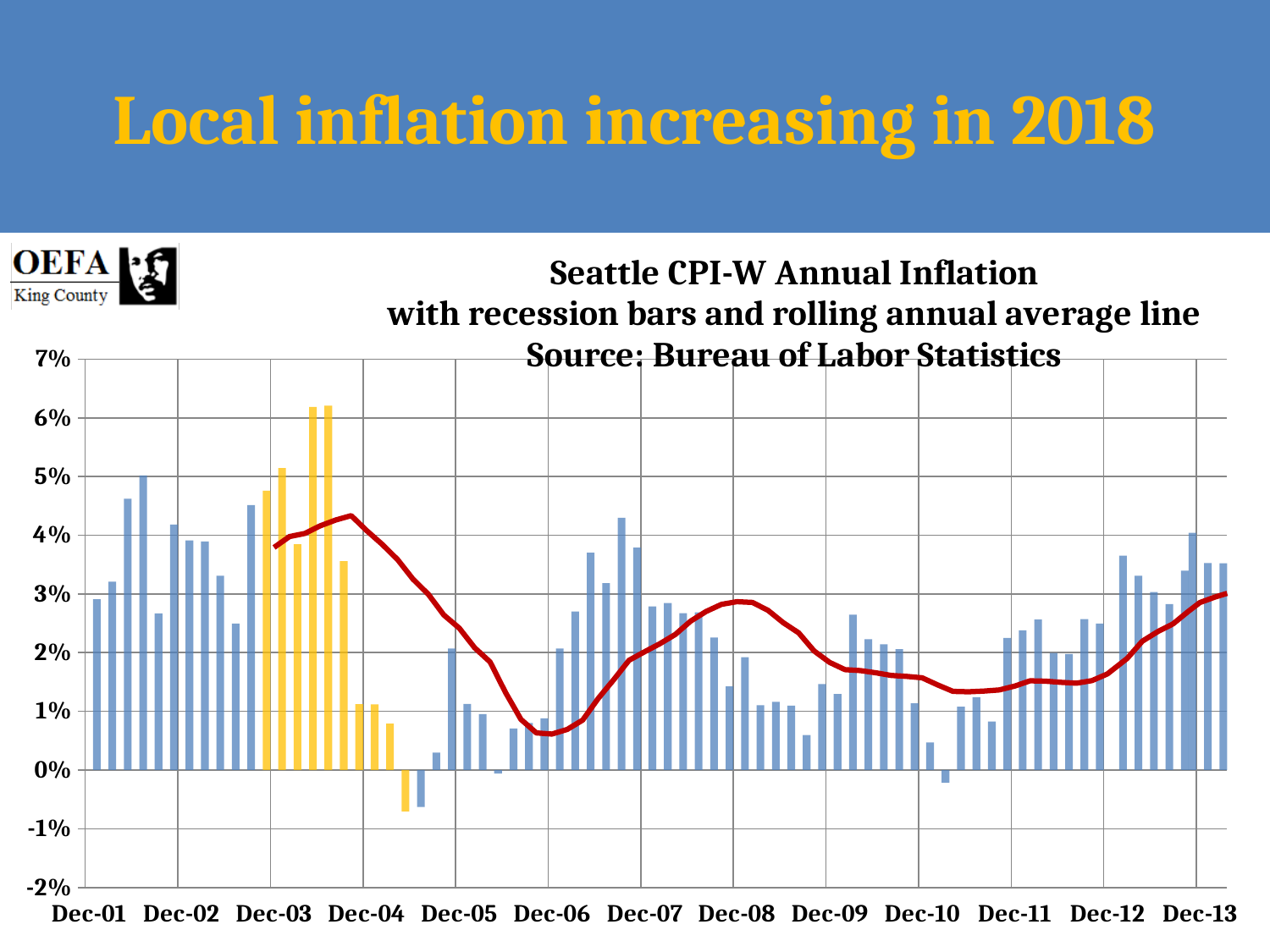
What source is cited in the chart title? Bureau of Labor Statistics Is the red rolling average line at Dec-06 greater or less than 1%? less Are the bars just after Dec-04 greater or less than 0%? less Is the value of the tallest yellow bar (between Dec-03 and Dec-04) greater or less than 6%? greater Does the red rolling average line rise or fall between Dec-04 and Dec-06? fall What kind of chart is shown on the slide? bar chart with a line overlay What colour are the recession bars on the chart? yellow Between which two x-axis labels do the tallest bars on the chart appear? Dec-03 and Dec-04 How many date labels are shown along the x axis of the chart? 13 Does the red rolling average line rise or fall between Dec-11 and Dec-13? rise